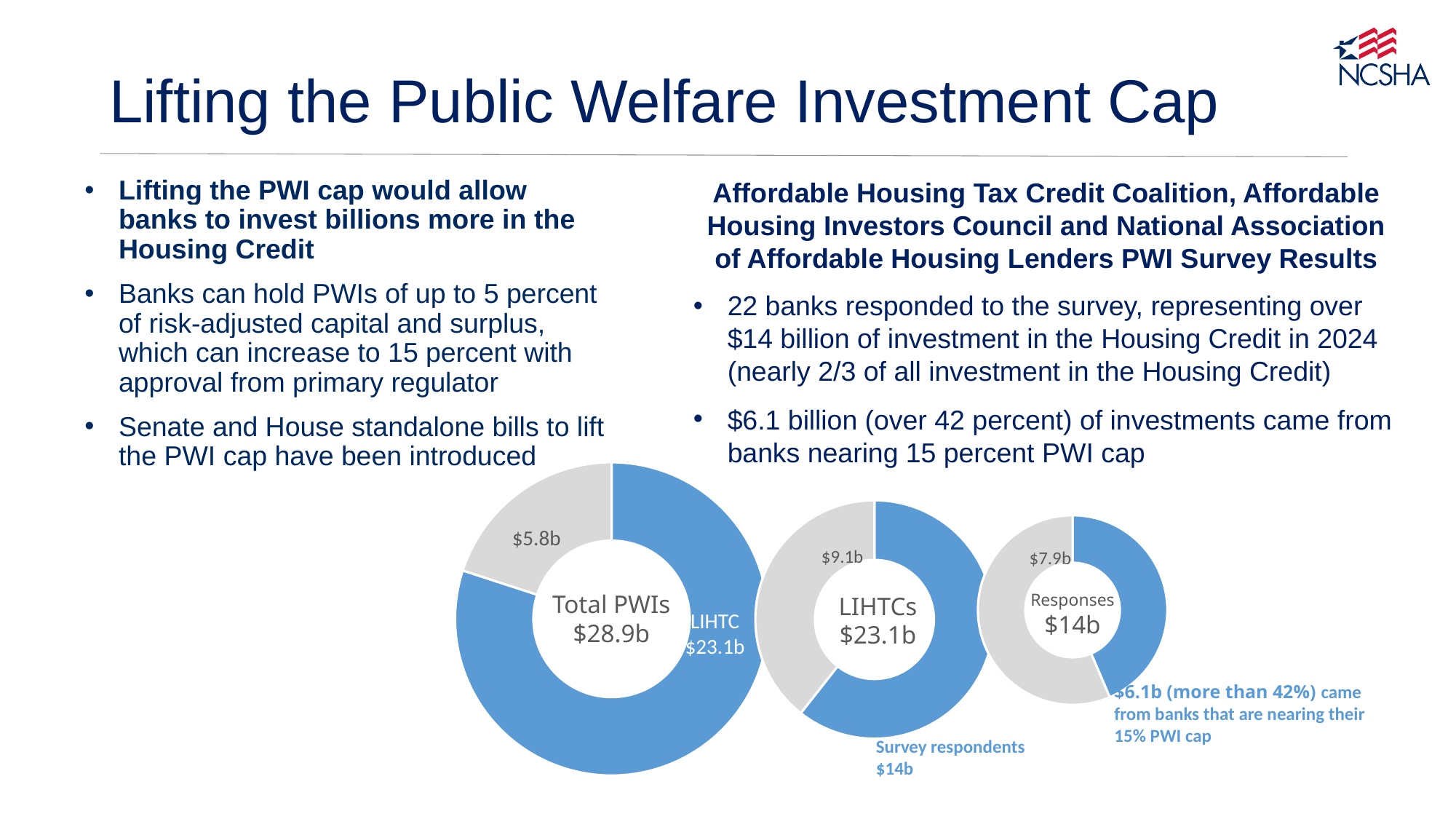
In the Responses chart, what is the value of the grey slice? $7.9b What kind of chart is used to show the Total PWIs breakdown? Donut (pie) chart In the Responses chart, which slice is larger: the $6.1b blue slice or the $7.9b grey slice? The $7.9b grey slice In the Responses chart, what is the value of the blue slice representing banks nearing their 15% PWI cap? $6.1b In the LIHTCs chart, what is the difference between the Survey respondents slice and the grey slice? $4.9b In the LIHTCs chart, what is the value of the grey slice? $9.1b In the Total PWIs chart, what is the value of the LIHTC slice? $23.1b In the Total PWIs chart, what is the value of the grey (non-LIHTC) slice? $5.8b In the Total PWIs chart, which slice is larger: LIHTC or the grey slice? LIHTC What total is shown in the centre of the Total PWIs chart? $28.9b How many donut charts are shown on the slide? 3 In the LIHTCs chart, what is the value of the Survey respondents slice? $14b